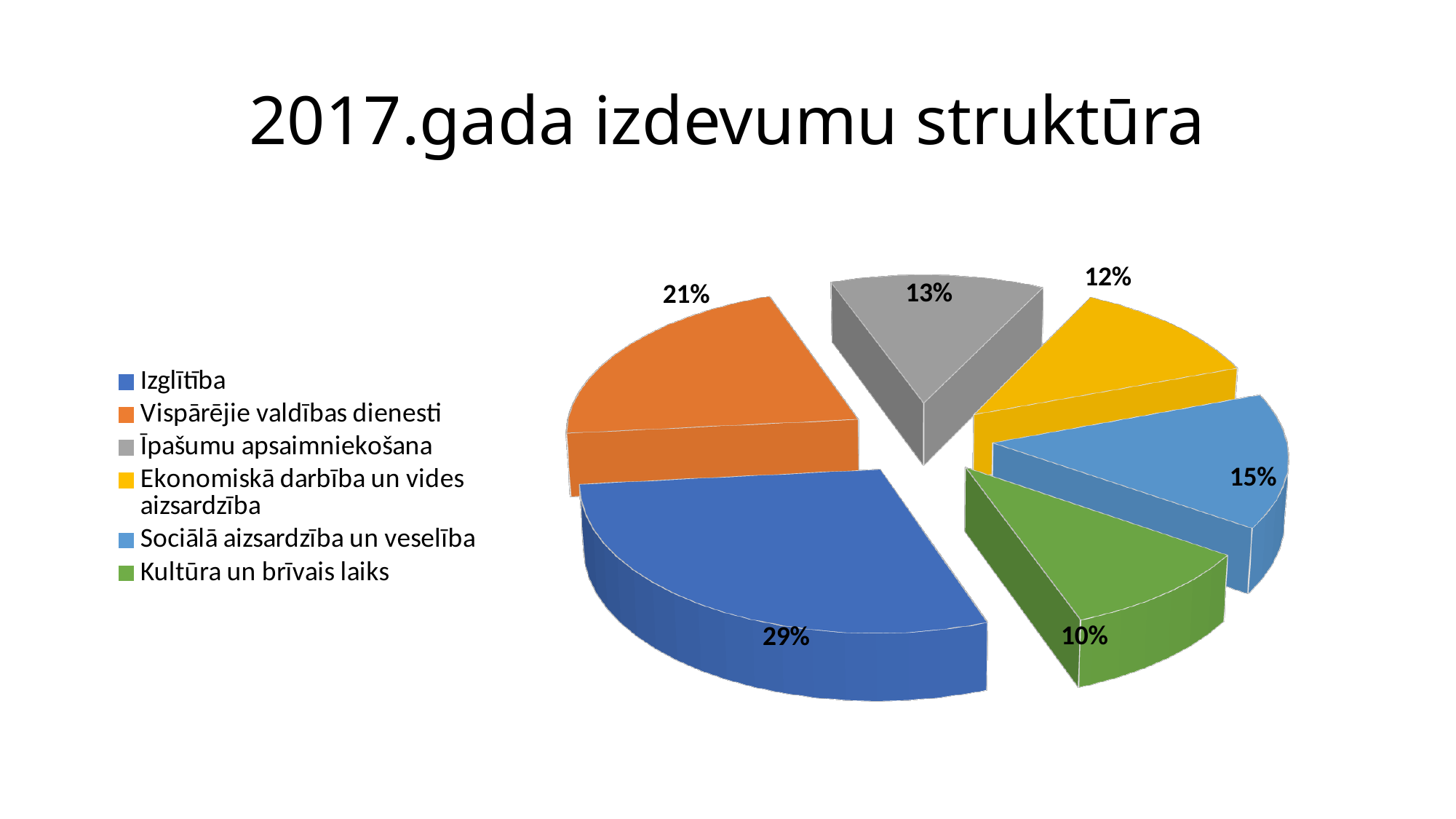
What share of the pie does Kultūra un brīvais laiks have? 10% What share of the pie does Izglītība have? 29% What share of the pie does Vispārējie valdības dienesti have? 21% What is the difference between the shares of Izglītība and Vispārējie valdības dienesti? 8% How many categories does the pie chart show? 6 What kind of chart is shown on the slide? Pie chart Which has a larger share, Sociālā aizsardzība un veselība or Īpašumu apsaimniekošana? Sociālā aizsardzība un veselība Which category has the largest share of the pie? Izglītība Which category has the smallest share of the pie? Kultūra un brīvais laiks